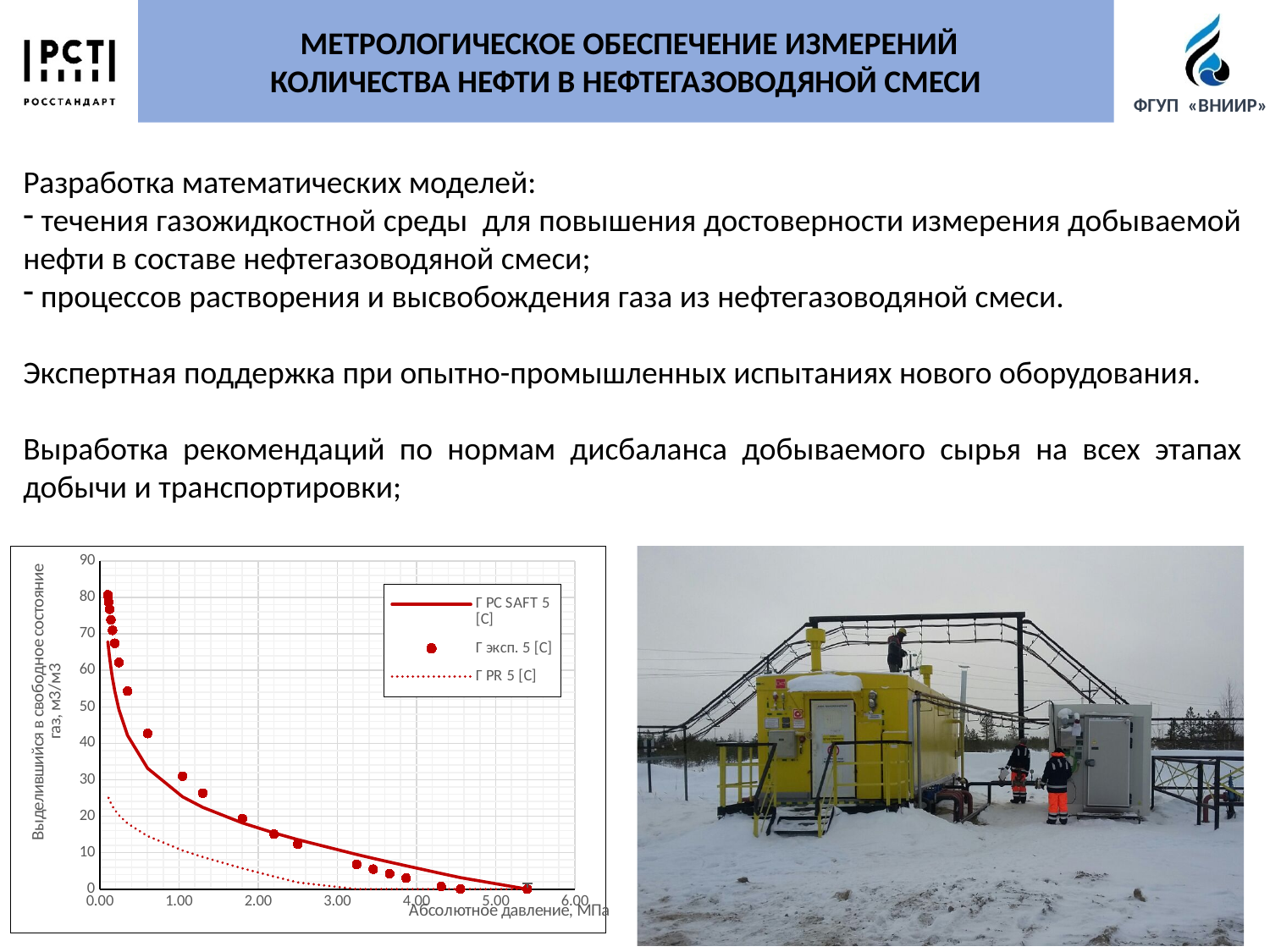
Is the value of the Г PR 5 [C] series at 1.00 MPa greater or less than 20? less Do the values on the chart rise or fall as absolute pressure increases along the x axis? fall At an absolute pressure of 1.00 MPa, which series has the higher value: Г PC SAFT 5 [C] or Г PR 5 [C]? Г PC SAFT 5 [C] How many series does the legend of the chart list? 3 What is the maximum value shown on the y axis of the chart? 90 Is the highest Г эксп. 5 [C] data point, near 0.10 MPa, greater or less than 70? greater What kind of chart is shown on the slide? line chart Is the value of the Г PR 5 [C] series at 2.00 MPa greater or less than 10? less Which series in the chart legend is drawn with a dotted line? Г PR 5 [C] What is the title of the x axis of the chart? Абсолютное давление, МПа